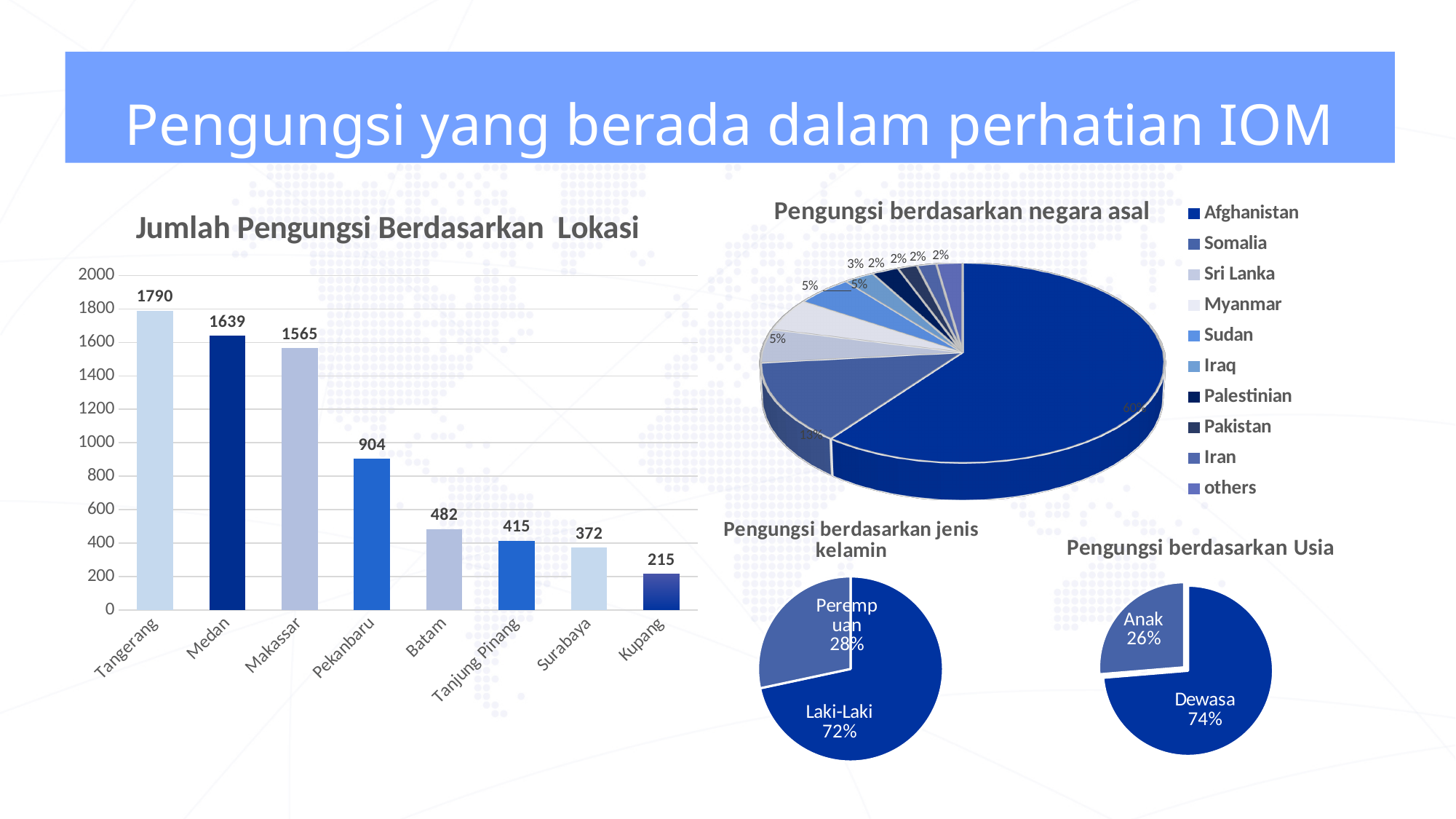
In the 'Jumlah Pengungsi Berdasarkan Lokasi' chart, do the values rise or fall from left to right? Fall In the 'Jumlah Pengungsi Berdasarkan Lokasi' chart, what is the value for Tangerang? 1790 In the 'Pengungsi berdasarkan negara asal' chart, which country has the largest slice? Afghanistan In the 'Jumlah Pengungsi Berdasarkan Lokasi' chart, what is the difference between Medan and Makassar? 74 What kind of chart is 'Jumlah Pengungsi Berdasarkan Lokasi'? Bar chart In the 'Jumlah Pengungsi Berdasarkan Lokasi' chart, which is larger, Batam or Surabaya? Batam In the 'Jumlah Pengungsi Berdasarkan Lokasi' chart, what is the value for Pekanbaru? 904 In the 'Pengungsi berdasarkan Usia' chart, what share is Anak? 26% In the 'Jumlah Pengungsi Berdasarkan Lokasi' chart, which location has the lowest value? Kupang How many locations are shown in the 'Jumlah Pengungsi Berdasarkan Lokasi' chart? 8 In the 'Pengungsi berdasarkan jenis kelamin' chart, what share is Laki-Laki? 72% How many countries/categories does the legend of the 'Pengungsi berdasarkan negara asal' chart list? 10